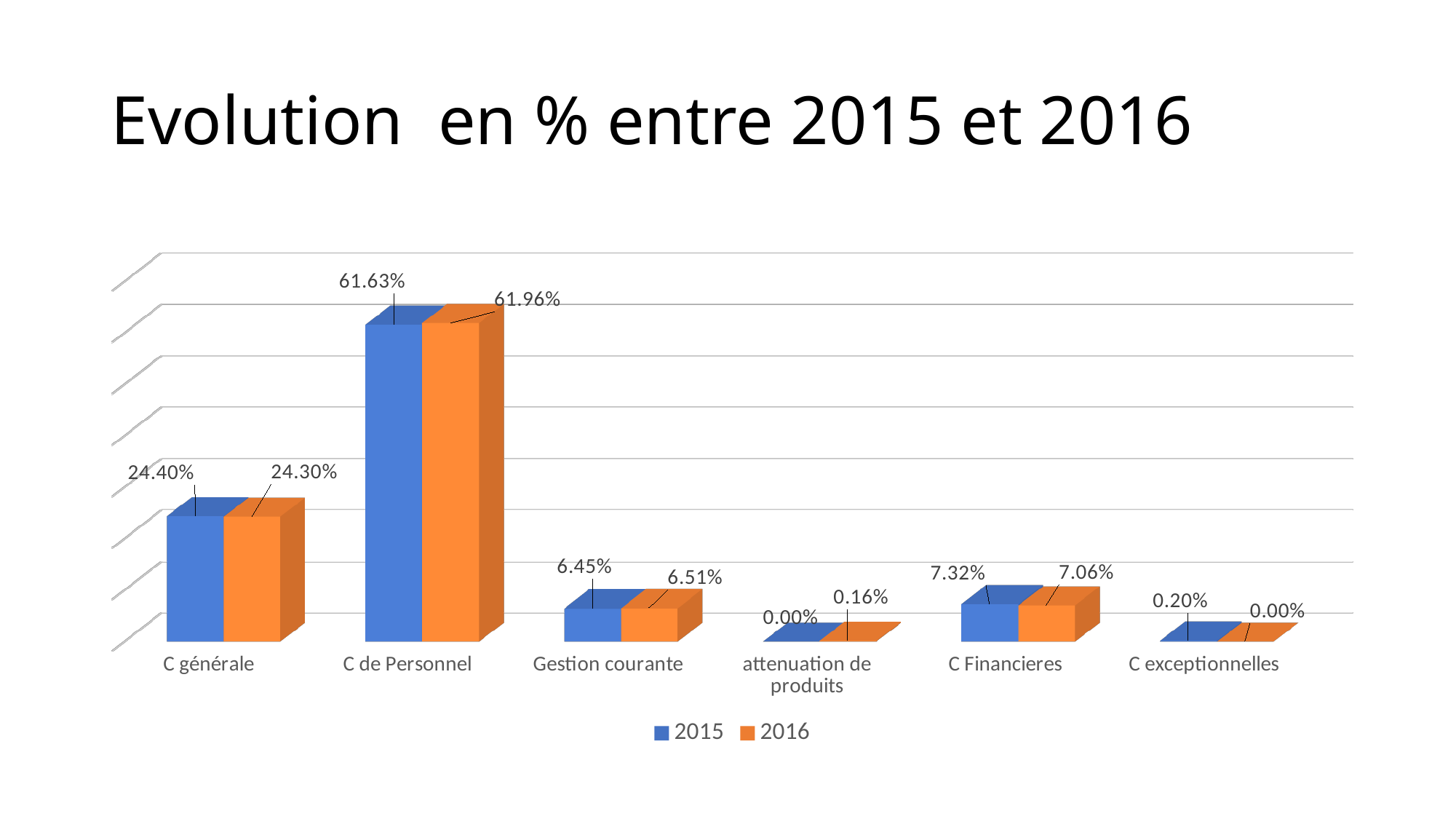
Which is larger for C Financieres, the 2015 value or the 2016 value? 2015 What is the value for attenuation de produits in 2016? 0.16% What kind of chart is shown on the slide? Bar chart Which category has the highest value in 2016? C de Personnel What is the value for C générale in 2016? 24.30% What is the difference between the 2016 and 2015 values for C de Personnel? 0.33% How many series does the legend list? 2 What is the value for C Financieres in 2015? 7.32% What is the value for Gestion courante in 2016? 6.51% Which category has the lowest value in 2015? attenuation de produits How many categories are shown on the x axis? 6 What is the value for C de Personnel in 2015? 61.63%